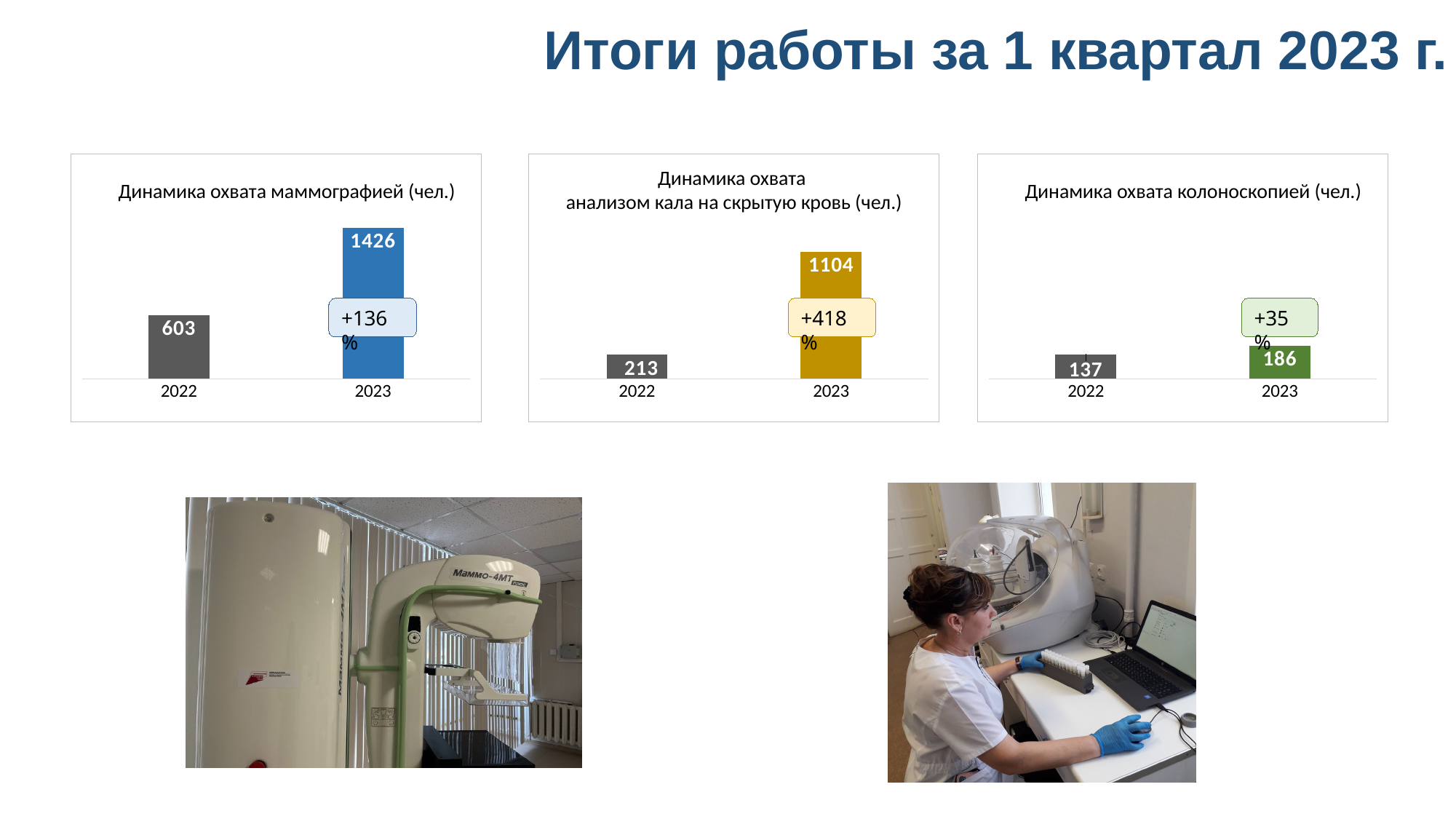
In the middle chart, "Динамика охвата анализом кала на скрытую кровь (чел.)", what is the value for 2022? 213 In the chart titled "Динамика охвата колоноскопией (чел.)", what is the value for 2022? 137 In the chart titled "Динамика охвата маммографией (чел.)", which year has the higher value? 2023 In the chart titled "Динамика охвата маммографией (чел.)", what is the value for 2023? 1426 In the chart titled "Динамика охвата колоноскопией (чел.)", what is the value for 2023? 186 In the chart titled "Динамика охвата маммографией (чел.)", what is the value for 2022? 603 In the chart titled "Динамика охвата колоноскопией (чел.)", what is the difference between the 2023 and 2022 values? 49 How many categories are shown on the x axis of the chart titled "Динамика охвата маммографией (чел.)"? 2 In the middle chart, "Динамика охвата анализом кала на скрытую кровь (чел.)", by how much does the 2023 value exceed the 2022 value? 891 In the middle chart, "Динамика охвата анализом кала на скрытую кровь (чел.)", what is the value for 2023? 1104 In the chart titled "Динамика охвата маммографией (чел.)", what is the difference between the 2023 and 2022 values? 823 What kind of chart is the chart titled "Динамика охвата колоноскопией (чел.)"? Bar chart